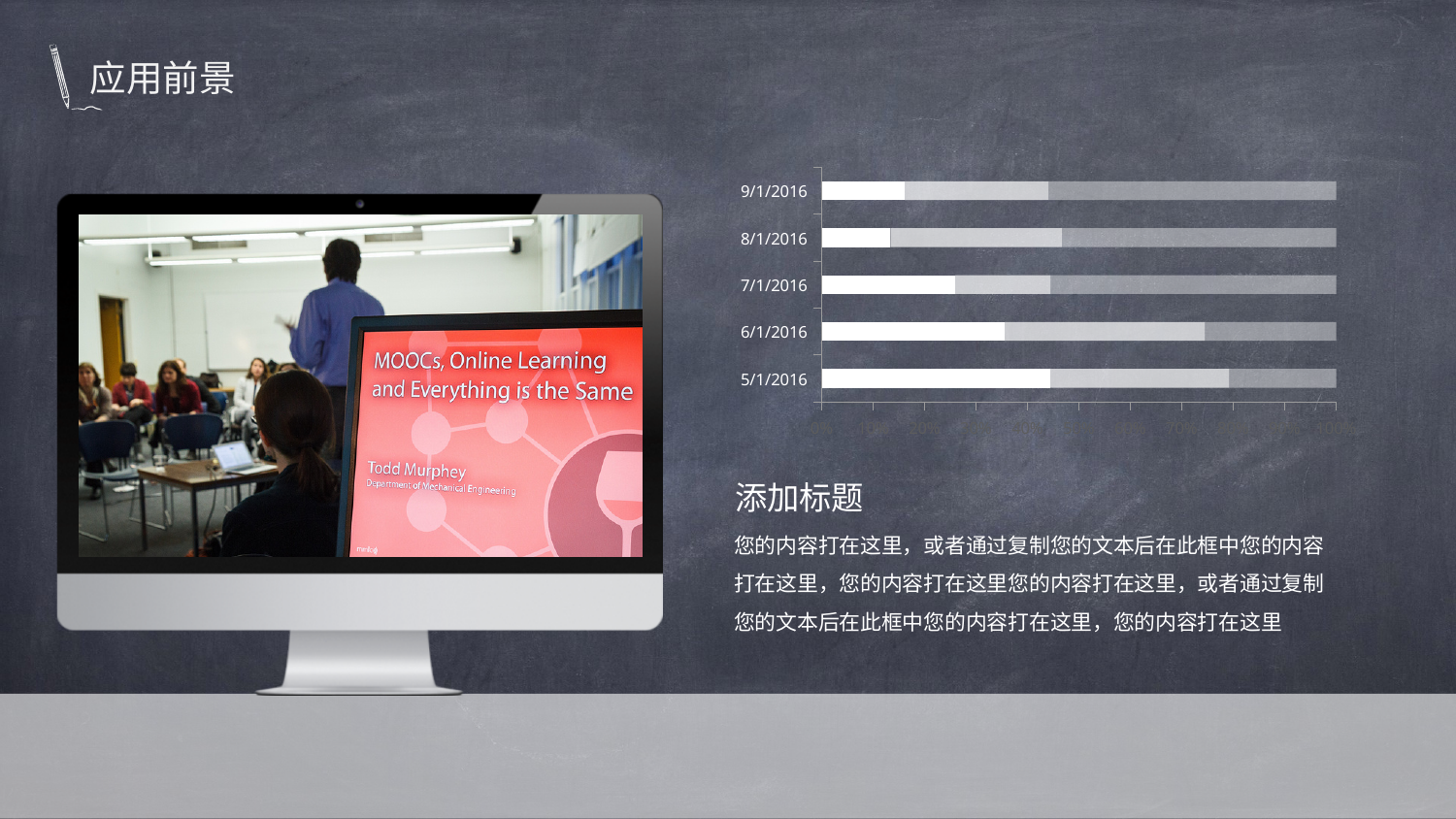
Is the white (first) segment longer for 6/1/2016 or for 7/1/2016? 6/1/2016 How many categories (dates) are shown on the chart's vertical axis? 5 What kind of chart is shown on the slide? bar chart Is the white (first) segment longer for 9/1/2016 or for 8/1/2016? 9/1/2016 Is the white (first) segment longer for 5/1/2016 or for 6/1/2016? 5/1/2016 Which date is listed at the bottom of the chart's vertical axis? 5/1/2016 Which date has the longest white (first) segment in its bar? 5/1/2016 Which date is listed at the top of the chart's vertical axis? 9/1/2016 Are the bars in the chart drawn horizontally or vertically? horizontally Which date has the shortest white (first) segment in its bar? 8/1/2016